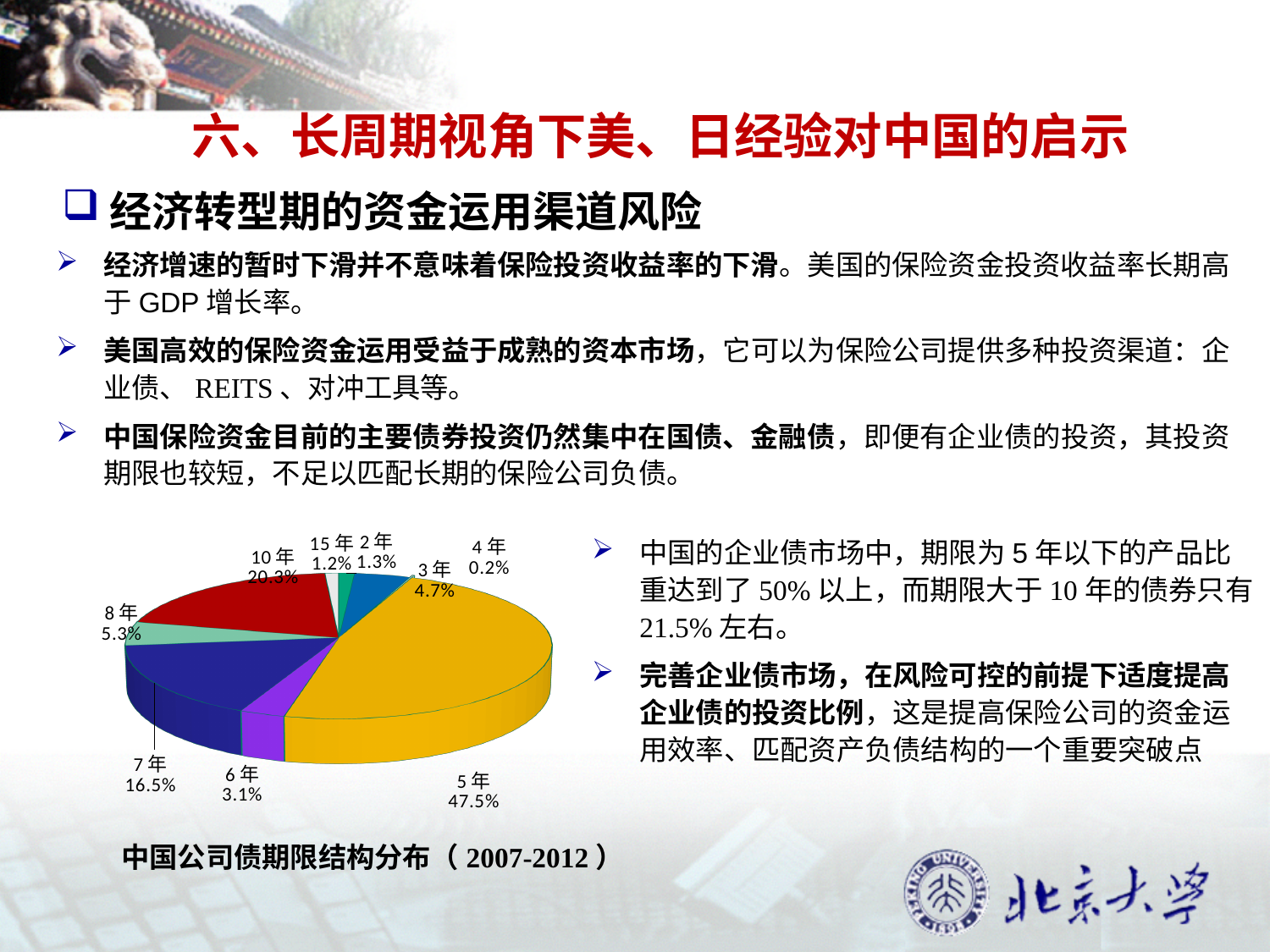
Which maturity has the largest share in the pie chart? 5年 What is the share for 4年 in the pie chart? 0.2% What kind of chart is shown on the slide? pie chart What is the share for 7年 in the pie chart? 16.5% What is the share for 10年 in the pie chart? 20.3% What is the share for 5年 in the pie chart? 47.5% What is the difference between the shares for 5年 and 10年? 27.2% How many slices does the pie chart have? 9 What is the combined share of 7年 and 8年 in the pie chart? 21.8% Which has a larger share, 8年 or 3年? 8年 What is the title of the pie chart? 中国公司债期限结构分布（2007-2012） Which maturity has the smallest share in the pie chart? 4年